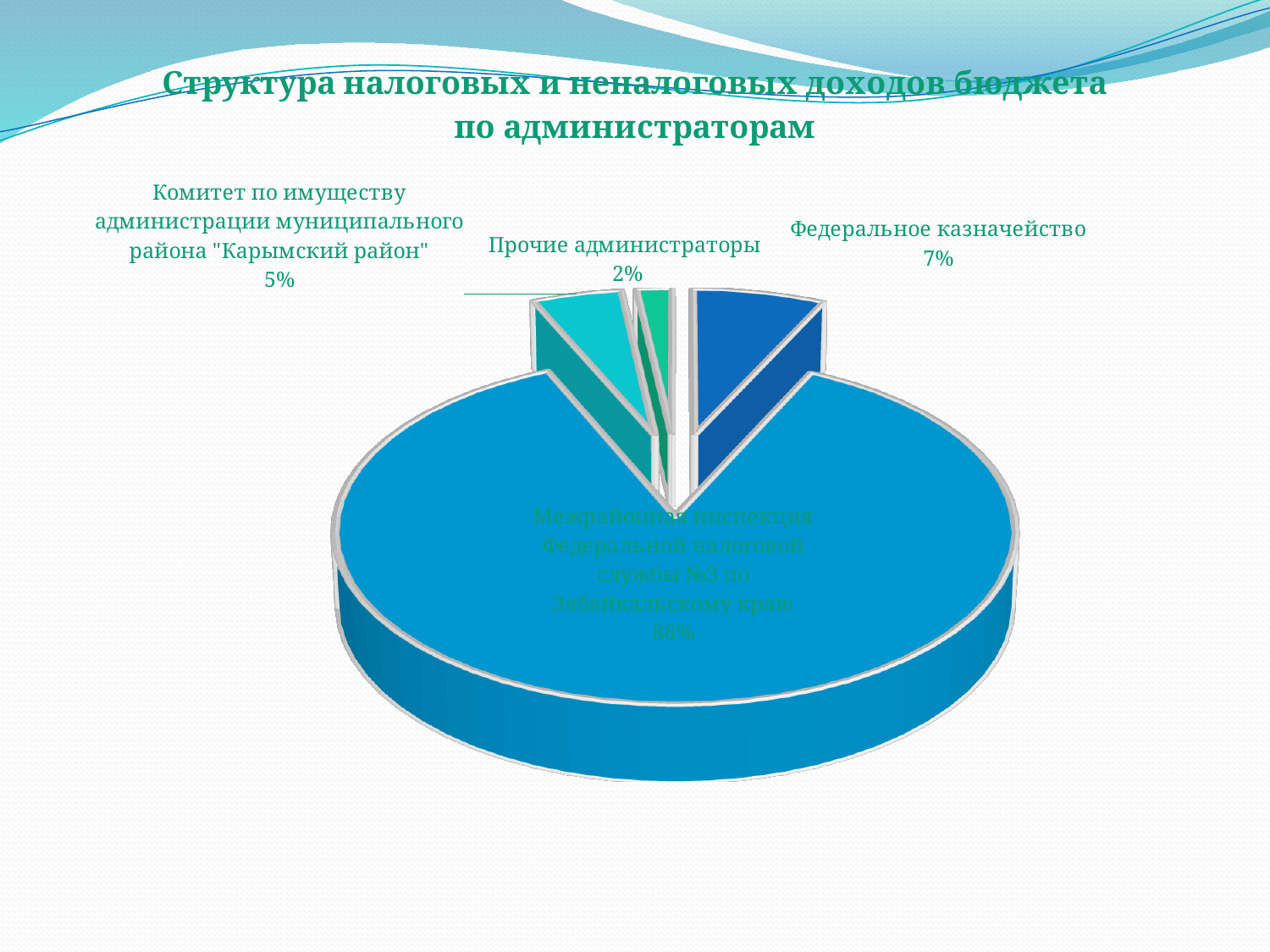
What is the difference in percentage points between the largest and smallest slices of the pie? 84 percentage points What share of the pie does Комитет по имуществу администрации муниципального района "Карымский район" hold? 5% What share of the pie does Прочие администраторы hold? 2% What is the difference in percentage points between the shares of Федеральное казначейство and Комитет по имуществу администрации муниципального района "Карымский район"? 2 percentage points Which is larger: the share of Федеральное казначейство or the share of Прочие администраторы? Федеральное казначейство What share of the pie does Федеральное казначейство hold? 7% Which administrator has the largest share of the pie? Межрайонная инспекция Федеральной налоговой службы №3 по Забайкальскому краю What kind of chart is shown on the slide? Pie chart Which administrator has the smallest share of the pie? Прочие администраторы What is the title of the chart on the slide? Структура налоговых и неналоговых доходов бюджета по администраторам How many slices does the pie chart have? 4